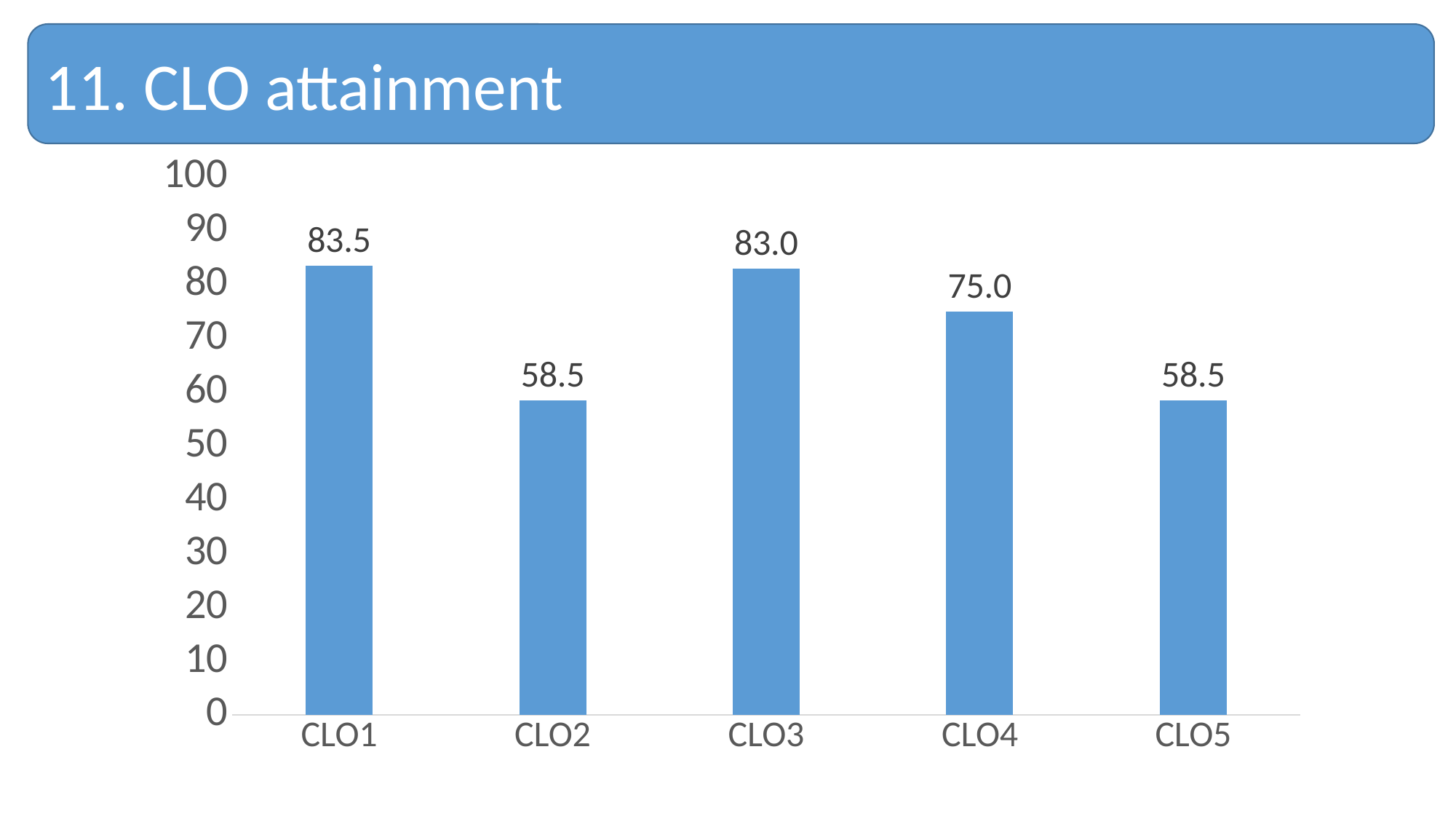
What is the value for CLO4? 75.0 Which category has the highest value? CLO1 What is the value for CLO1? 83.5 What kind of chart is shown on the slide? bar chart What is the title of the slide? 11. CLO attainment What is the value for CLO3? 83.0 How many categories are shown on the x axis? 5 Which is larger, the value for CLO4 or the value for CLO5? CLO4 Is the value for CLO2 greater or less than 60? less Is the value for CLO3 greater or less than 80? greater What is the difference between the values for CLO3 and CLO4? 8.0 What is the difference between the values for CLO1 and CLO2? 25.0